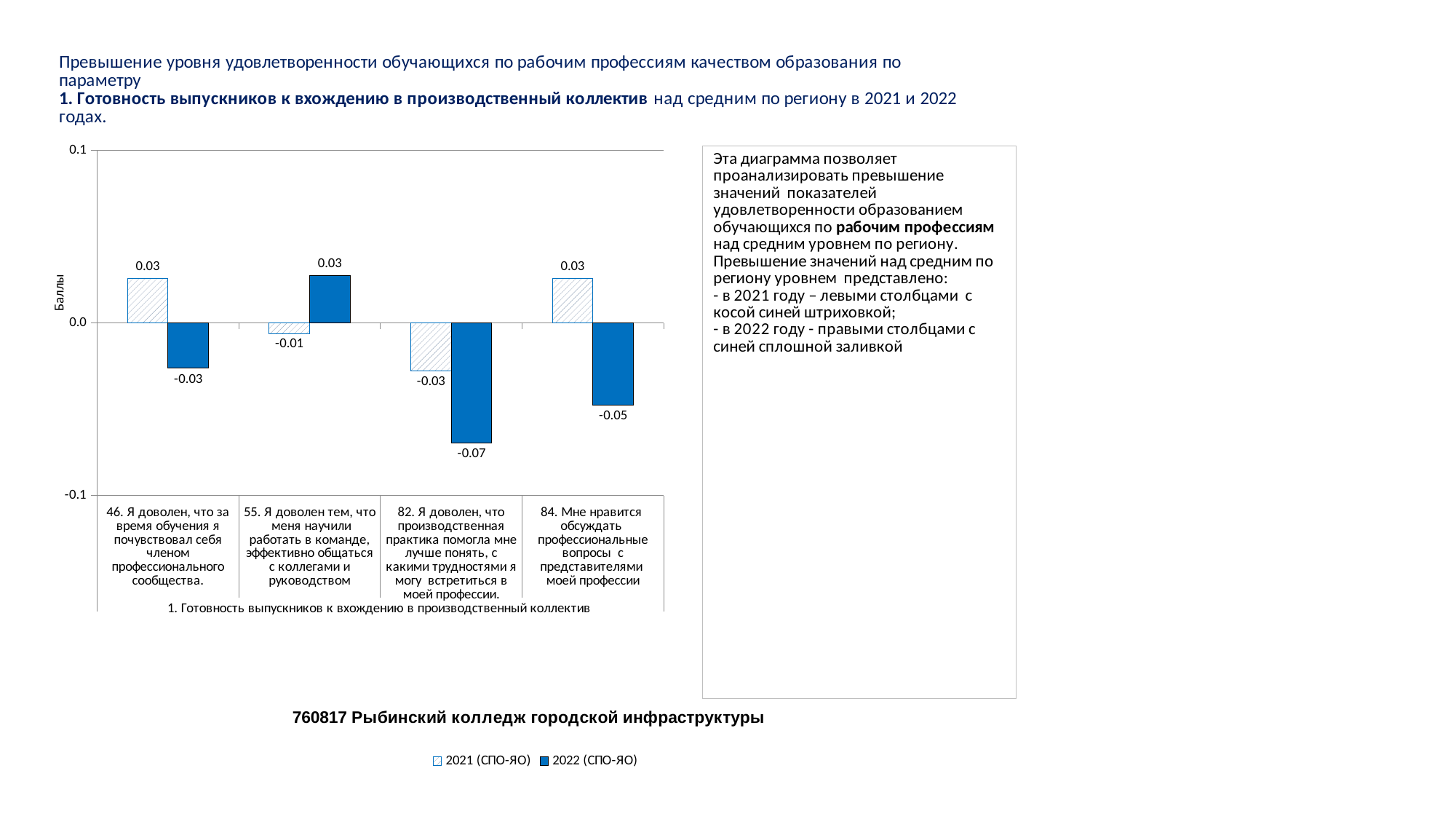
What type of chart is shown on the slide? bar chart For question 55, which series has the larger value: 2021 (СПО-ЯО) or 2022 (СПО-ЯО)? 2022 (СПО-ЯО) What is the value for 2021 (СПО-ЯО) for question 55 (Я доволен тем, что меня научили работать в команде)? -0.01 What is the label of the y axis of the chart? Баллы How many series does the chart legend list? 2 What is the value for 2022 (СПО-ЯО) for question 84 (Мне нравится обсуждать профессиональные вопросы с представителями моей профессии)? -0.05 Which category has the lowest value for the 2022 (СПО-ЯО) series? 82. Я доволен, что производственная практика помогла мне лучше понять, с какими трудностями я могу встретиться в моей профессии. How many categories (questions) are shown on the x axis of the chart? 4 Which category has the highest value for the 2022 (СПО-ЯО) series? 55. Я доволен тем, что меня научили работать в команде, эффективно общаться с коллегами и руководством What is the value for 2021 (СПО-ЯО) for question 46 (Я доволен, что за время обучения я почувствовал себя членом профессионального сообщества)? 0.03 What is the difference between the 2021 (СПО-ЯО) and 2022 (СПО-ЯО) values for question 82? 0.04 What is the value for 2022 (СПО-ЯО) for question 82 (Я доволен, что производственная практика помогла мне лучше понять, с какими трудностями я могу встретиться в моей профессии)? -0.07